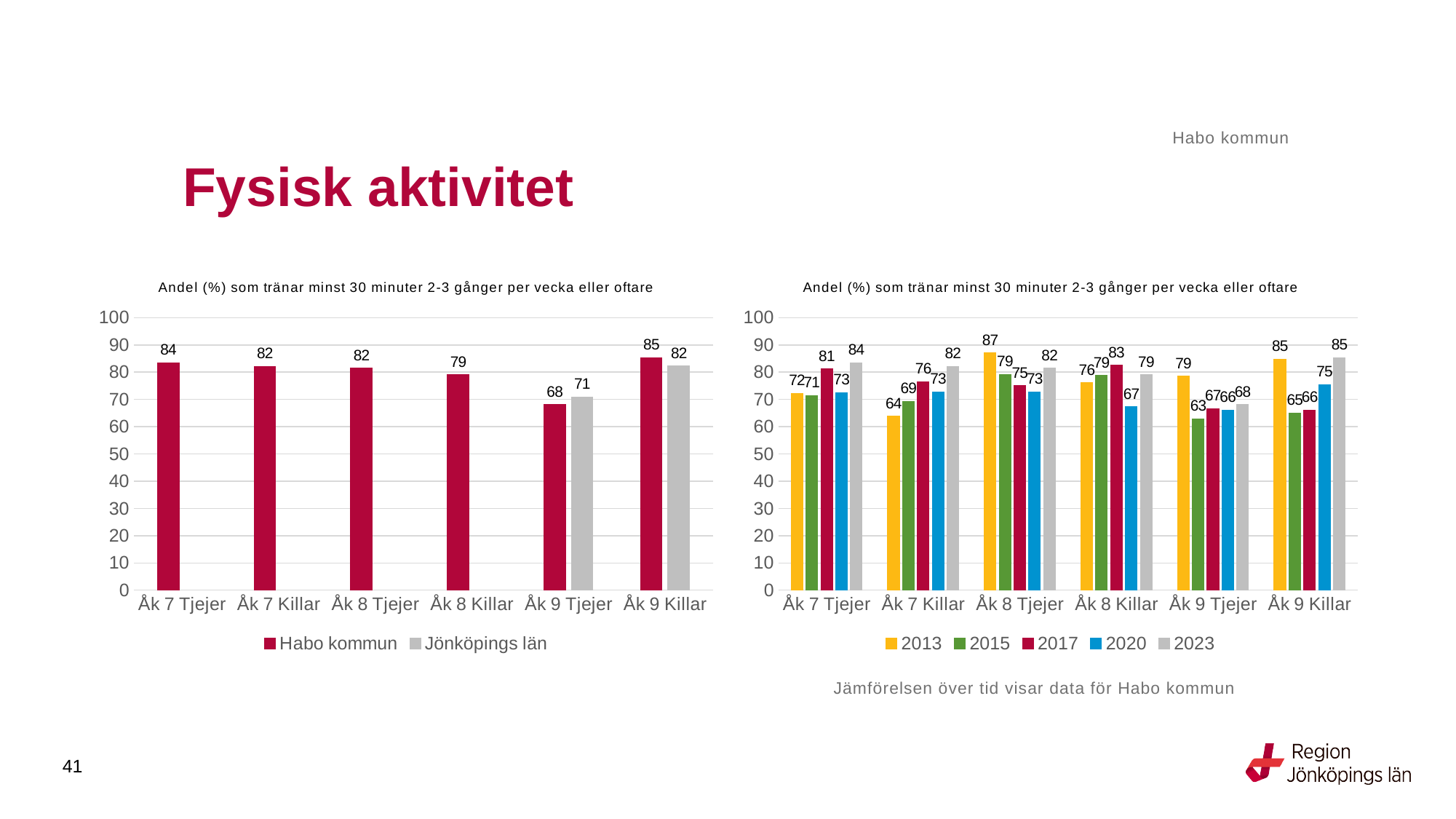
In the right chart, how many series does the legend list? 5 In the right chart, which year has the lowest value for Åk 9 Tjejer? 2015 In the left chart, which category has the highest Habo kommun value? Åk 9 Killar In the left chart, what is the value for Jönköpings län for Åk 9 Killar? 82 In the left chart, what is the difference between the Habo kommun and Jönköpings län values for Åk 9 Tjejer? 3 What kind of chart is the right chart? Bar chart In the right chart, what is the value for 2020 for Åk 8 Killar? 67 In the right chart, what is the value for 2013 for Åk 8 Tjejer? 87 In the left chart, which category has the lowest Habo kommun value? Åk 9 Tjejer In the left chart, what is the value for Habo kommun for Åk 9 Tjejer? 68 In the left chart, how many series does the legend list? 2 In the right chart, is the 2023 value for Åk 7 Killar larger than the 2013 value for Åk 7 Killar? Yes, 2023 (82) is larger than 2013 (64)